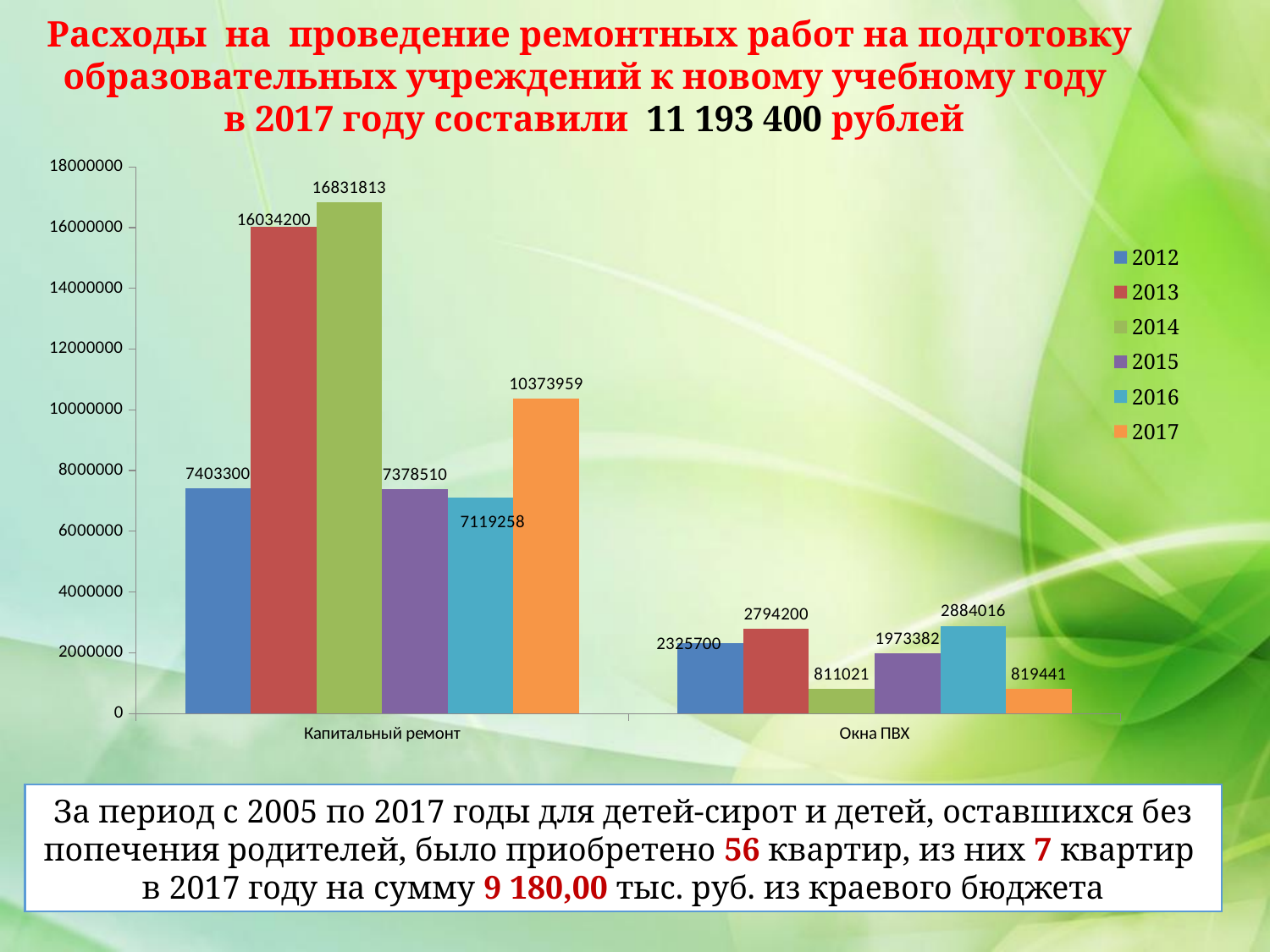
What is the value for 2014 in the Капитальный ремонт category? 16831813 What is the value for 2017 in the Окна ПВХ category? 819441 What is the value for 2016 in the Капитальный ремонт category? 7119258 How many series does the legend list? 6 What is the difference between the 2016 and 2015 values in the Окна ПВХ category? 910634 How many categories are shown on the x axis? 2 Which year has the lowest value in the Окна ПВХ category? 2014 Which year has the highest value in the Капитальный ремонт category? 2014 What is the difference between the 2014 and 2013 values in the Капитальный ремонт category? 797613 Which is larger in the Окна ПВХ category: the value for 2016 or the value for 2013? 2016 What kind of chart is shown on the slide? bar chart Is the value for 2017 in the Капитальный ремонт category greater or less than 10000000? greater